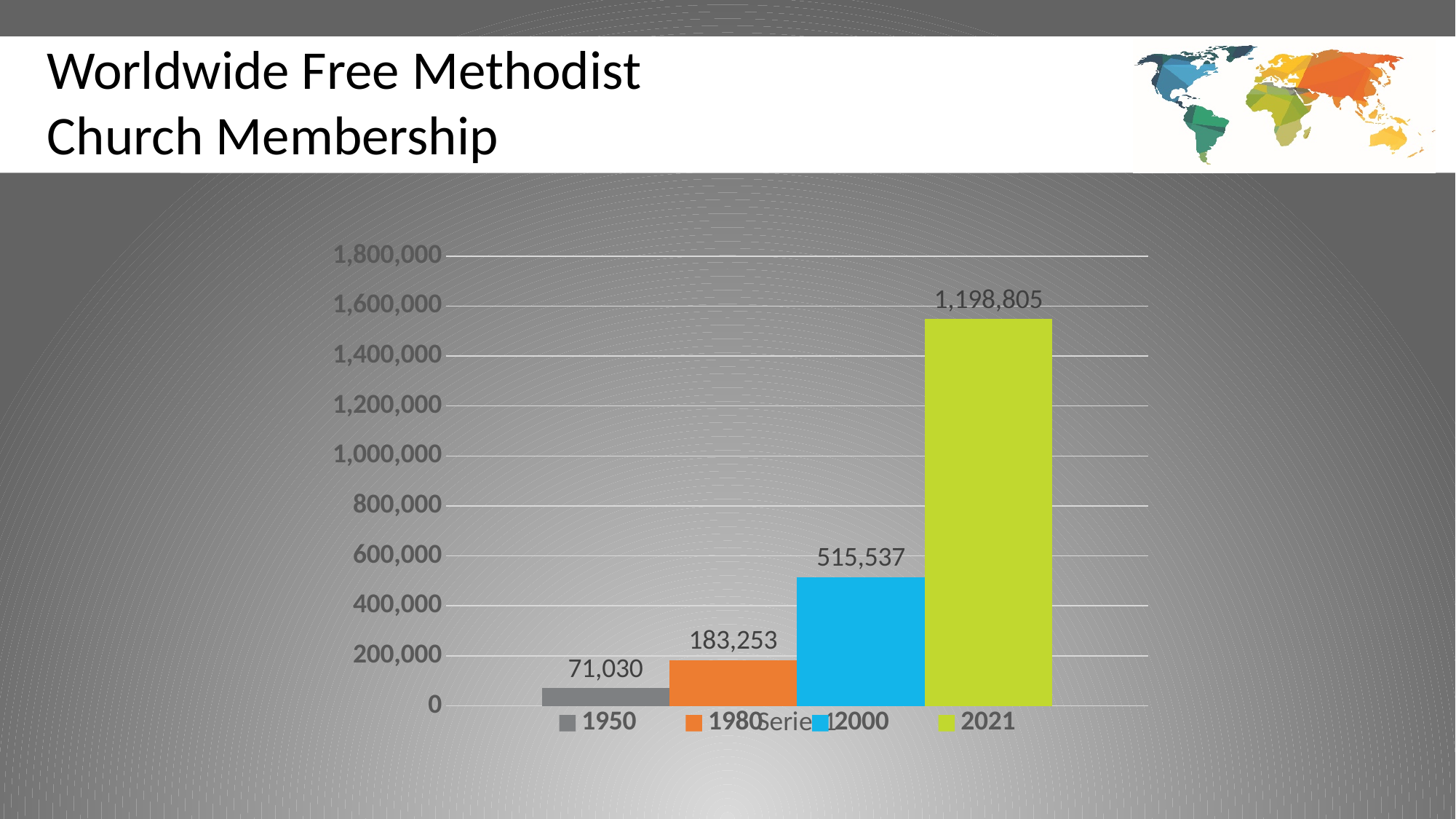
What is the membership value shown for 1950? 71,030 What is the membership value shown for 2021? 1,198,805 How many series does the legend list? 4 What kind of chart is shown on the slide? bar chart What is the difference between the 2000 and 1980 membership values? 332,284 What is the difference between the 1980 and 1950 membership values? 112,223 Which year has the highest membership value? 2021 Which is larger, the value for 2000 or the value for 1980? 2000 What is the membership value shown for 1980? 183,253 Is the value for 2000 greater or less than 400,000? greater What is the membership value shown for 2000? 515,537 Which year has the lowest membership value? 1950